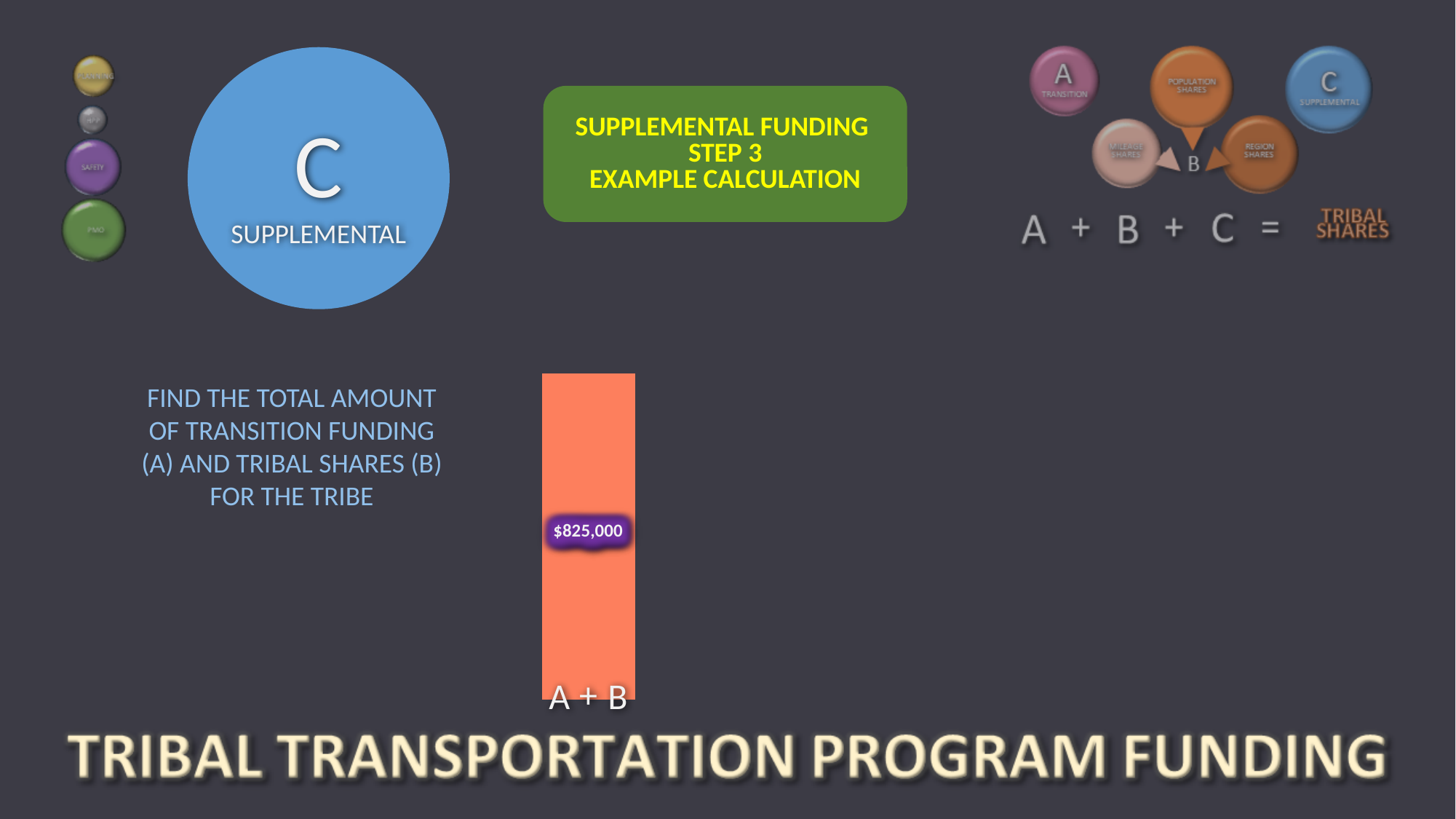
Is the value for A + B greater or less than $500,000? greater What kind of chart is shown on the slide? bar chart What is the value shown for the A + B bar? $825,000 Is the value for A + B greater or less than $1,000,000? less How many bars are plotted in the chart? 1 What is the category label under the bar? A + B What colour is the A + B bar? orange